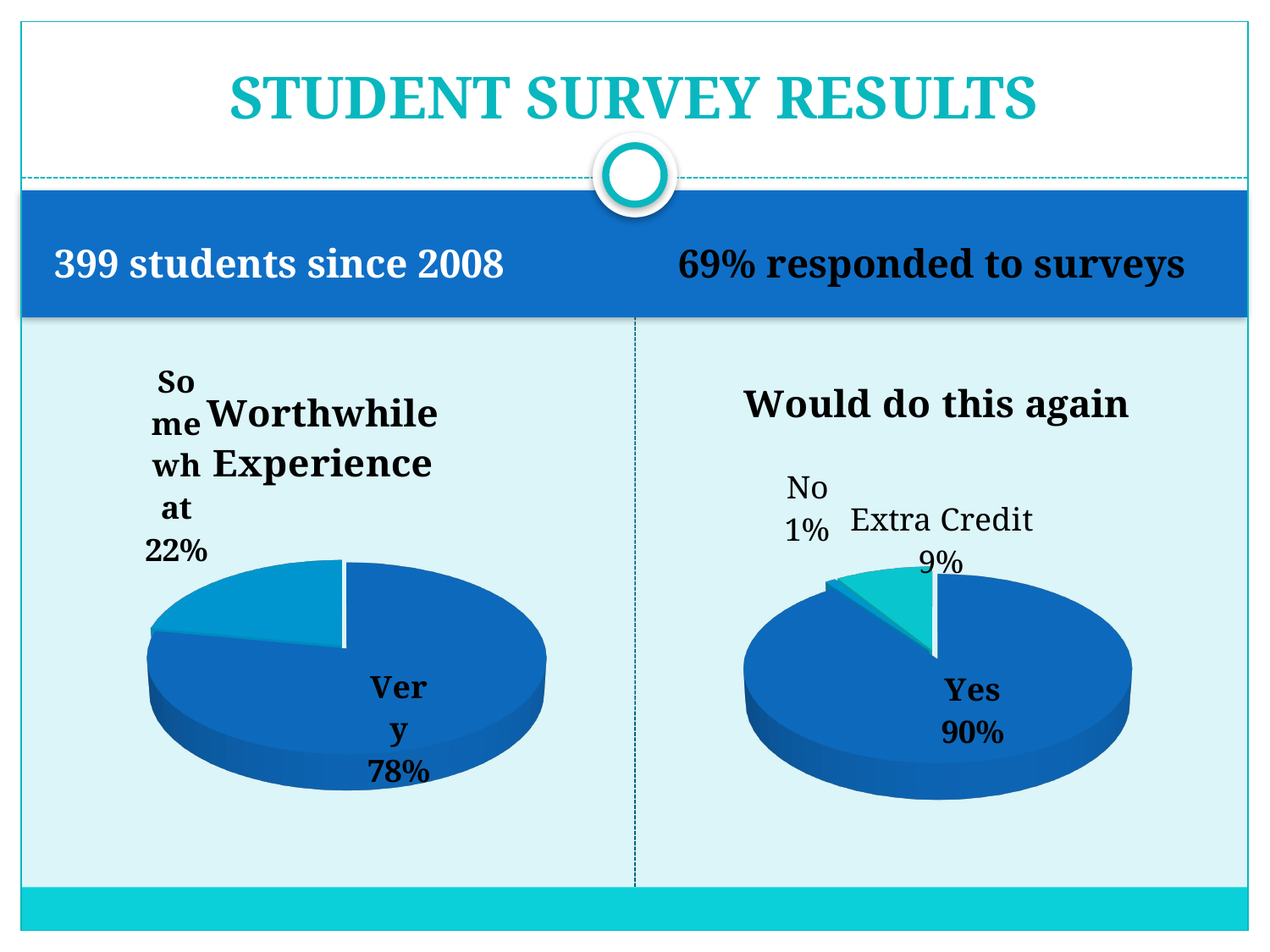
How many slices does the "Worthwhile Experience" chart have? 2 In the "Worthwhile Experience" chart, what is the difference in percentage points between "Very" and "Somewhat"? 56 In the "Worthwhile Experience" chart, what percentage of students answered "Somewhat"? 22% In the "Would do this again" chart, what percentage answered "Yes"? 90% In the "Would do this again" chart, which is larger, "Extra Credit" or "No"? Extra Credit In the "Would do this again" chart, what percentage answered "Extra Credit"? 9% In the "Would do this again" chart, which response has the smallest slice? No In the "Would do this again" chart, which response has the largest slice? Yes In the "Would do this again" chart, what percentage answered "No"? 1% In the "Worthwhile Experience" chart, what percentage of students answered "Very"? 78% What type of chart is used for "Worthwhile Experience"? Pie chart How many slices does the "Would do this again" chart have? 3